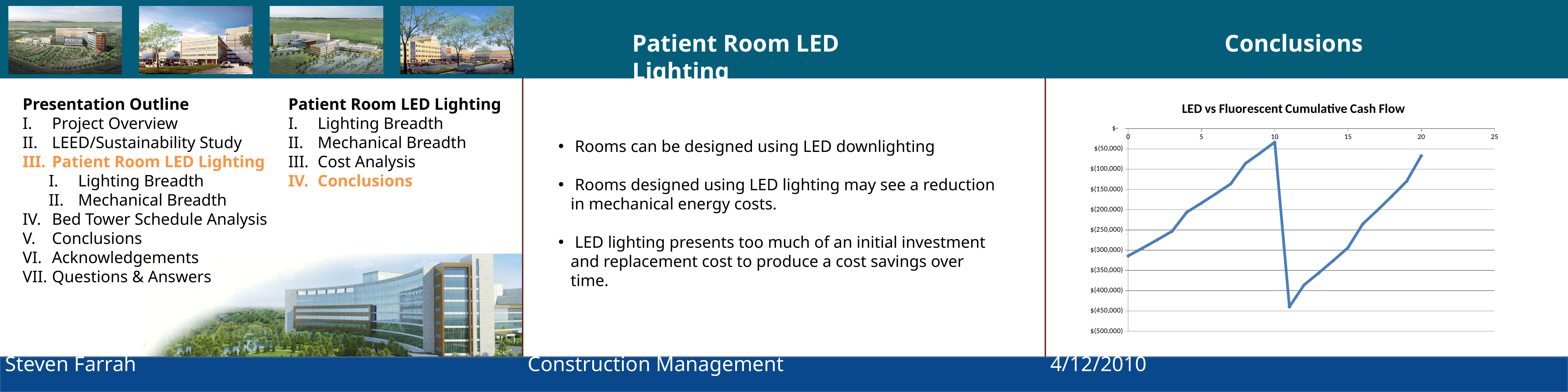
What is the title of the chart on the slide? LED vs Fluorescent Cumulative Cash Flow What kind of chart is shown on the slide? line chart Is the lowest point of the line above or below the $(400,000) gridline? below Is the value of the line at x = 10 above or below the $(100,000) gridline? above Is the value of the line at x = 20 above or below the $(100,000) gridline? above How many lines are plotted in the LED vs Fluorescent Cumulative Cash Flow chart? 1 What is the largest tick value shown on the x axis of the chart? 25 What is the lowest value labelled on the y axis of the chart? $(500,000) Does the line rise or fall between x = 0 and x = 10? rise At which x-axis tick does the line reach its highest point? 10 Which is higher on the chart, the value at x = 10 or the value at x = 20? x = 10